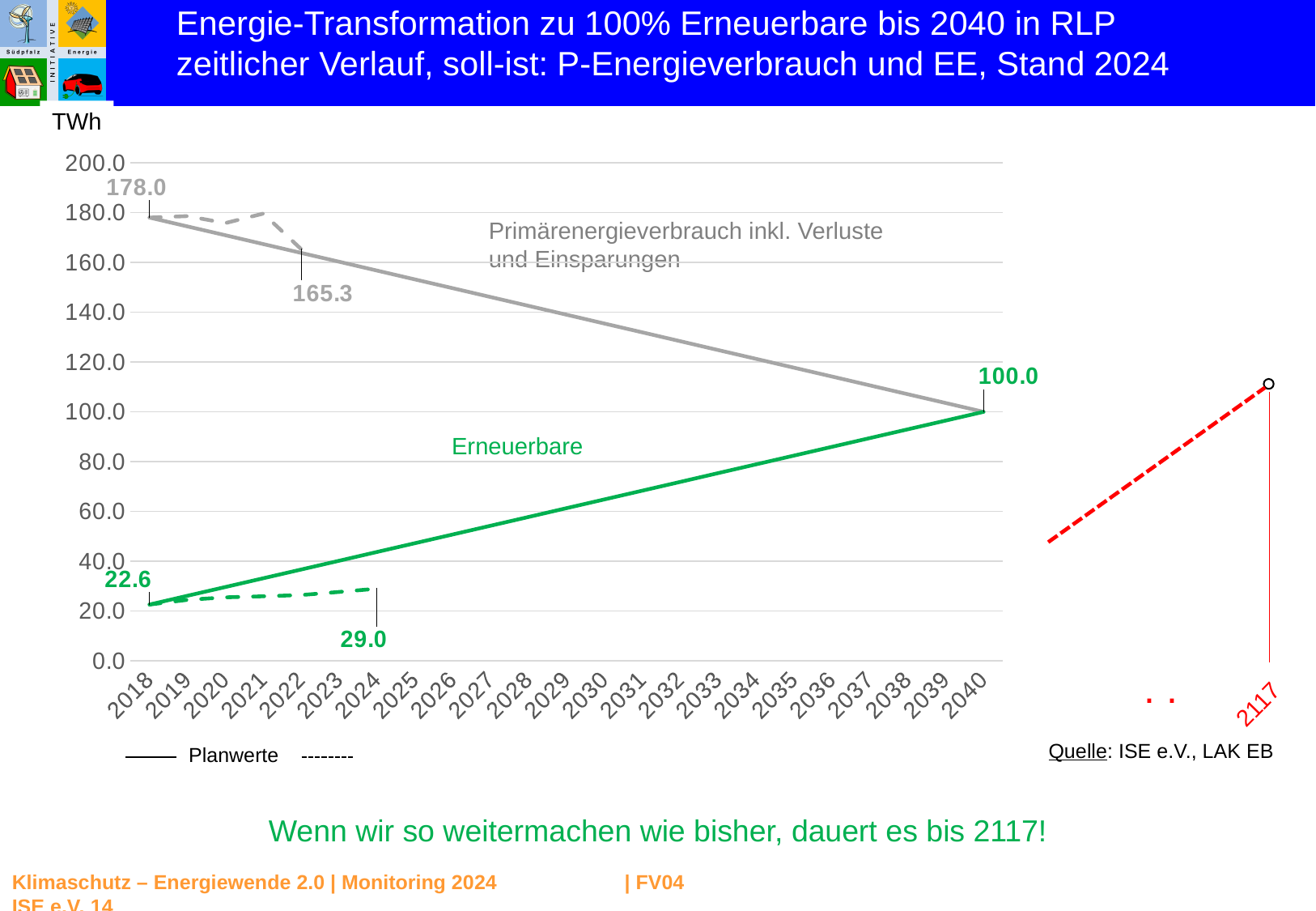
Is the planned Primärenergieverbrauch value for 2030 greater or less than 120? greater What is the labelled actual value of Primärenergieverbrauch in 2022? 165.3 What kind of chart is shown on the slide? line chart What is the value of Erneuerbare in 2018? 22.6 Does the planned Erneuerbare line rise or fall from 2018 to 2040? rise What is the difference between Primärenergieverbrauch and Erneuerbare in 2018? 155.4 At what value do the Primärenergieverbrauch and Erneuerbare lines meet in 2040? 100.0 What is the labelled actual value of Erneuerbare in 2024? 29.0 By how much did the actual Erneuerbare value in 2024 (29.0) exceed the 2018 value (22.6)? 6.4 What unit is shown on the y axis of the chart? TWh What is the value of Primärenergieverbrauch in 2018? 178.0 Which is larger in 2018, Primärenergieverbrauch or Erneuerbare? Primärenergieverbrauch